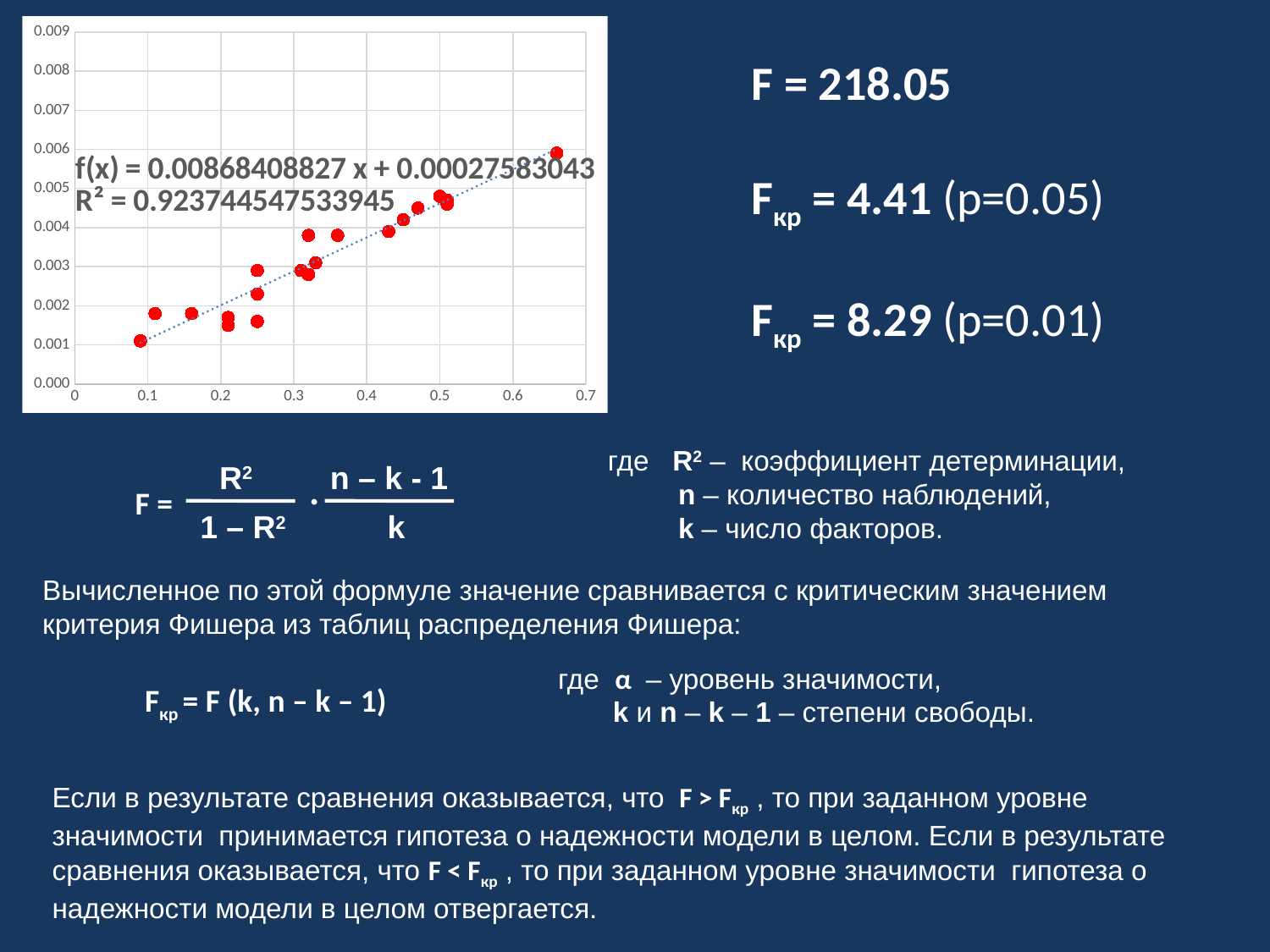
Is the point with the lowest y value the leftmost or the rightmost point on the chart? leftmost Which point has the higher y value, the leftmost point or the rightmost point? rightmost Is the highest plotted y value greater or less than 0.007? less Is the y value of the leftmost point greater or less than 0.002? less What kind of chart is shown on the slide? scatter chart Is the y value of the rightmost point greater or less than 0.005? greater Is the point with the highest y value the leftmost or the rightmost point on the chart? rightmost What R² value is printed on the chart? R² = 0.923744547533945 What trendline equation is printed on the chart? f(x) = 0.00868408827 x + 0.00027583043 Do the plotted y values generally rise or fall as x increases? rise